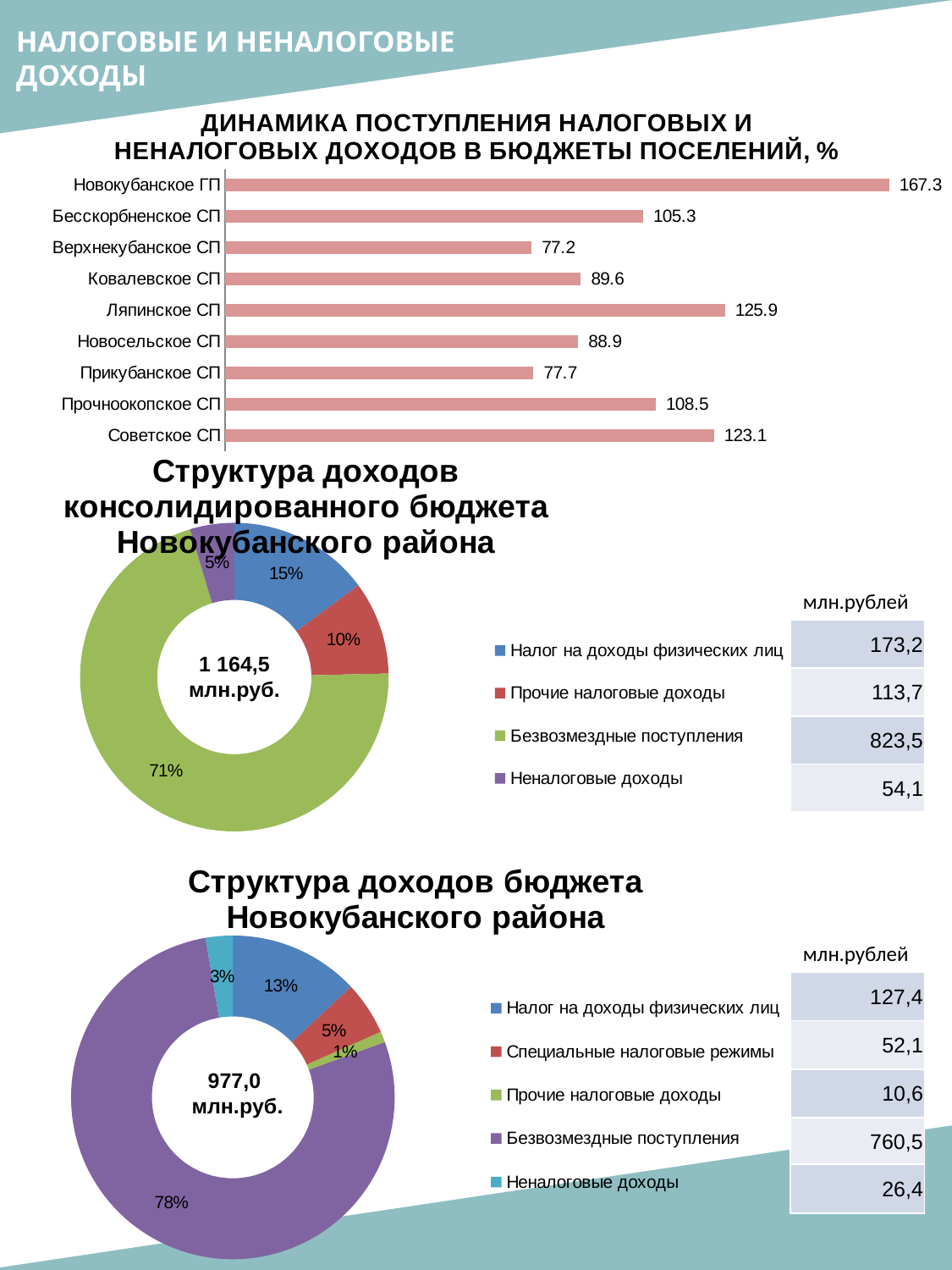
In the chart 'Структура доходов консолидированного бюджета Новокубанского района', what share do Безвозмездные поступления make up? 71% What type of chart is 'Динамика поступления налоговых и неналоговых доходов в бюджеты поселений, %'? Bar chart In the bar chart 'Динамика поступления налоговых и неналоговых доходов в бюджеты поселений, %', which is larger: Бесскорбненское СП or Прочноокопское СП? Прочноокопское СП How many categories does the legend of the chart 'Структура доходов бюджета Новокубанского района' list? 5 In the bar chart 'Динамика поступления налоговых и неналоговых доходов в бюджеты поселений, %', what is the value for Ляпинское СП? 125.9 In the bar chart 'Динамика поступления налоговых и неналоговых доходов в бюджеты поселений, %', how many settlements are shown? 9 In the bar chart 'Динамика поступления налоговых и неналоговых доходов в бюджеты поселений, %', what is the difference between Новокубанское ГП and Советское СП? 44.2 In the chart 'Структура доходов консолидированного бюджета Новокубанского района', what is the value in млн.рублей for Налог на доходы физических лиц? 173,2 In the bar chart 'Динамика поступления налоговых и неналоговых доходов в бюджеты поселений, %', which settlement has the highest value? Новокубанское ГП In the chart 'Структура доходов бюджета Новокубанского района', which category has the smallest share? Прочие налоговые доходы In the chart 'Структура доходов бюджета Новокубанского района', what is the value in млн.рублей for Безвозмездные поступления? 760,5 In the chart 'Структура доходов консолидированного бюджета Новокубанского района', what total is shown in the centre of the donut? 1 164,5 млн.руб.